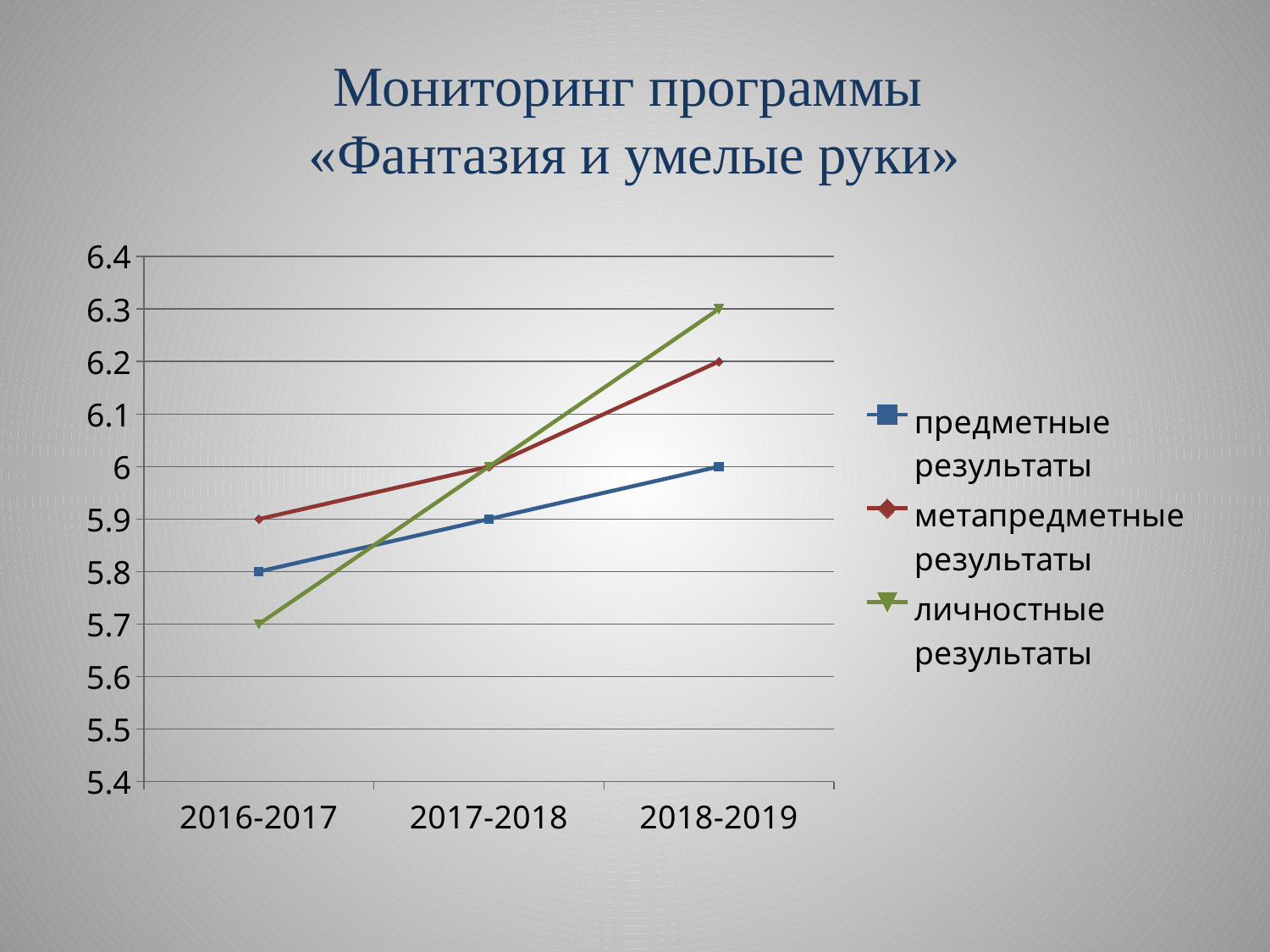
What is the value of метапредметные результаты in 2017-2018? 6 Which is larger in 2016-2017: предметные результаты or метапредметные результаты? метапредметные результаты Which series has the lowest value in 2016-2017? личностные результаты Which series has the highest value in 2018-2019? личностные результаты What is the value of предметные результаты in 2016-2017? 5.8 What colour is the line for метапредметные результаты? red Do the values of предметные результаты rise or fall from 2016-2017 to 2018-2019? rise What kind of chart is shown on the slide? line chart What is the value of личностные результаты in 2018-2019? 6.3 How many points are plotted along the x axis for each series? 3 How many series does the legend list? 3 What is the difference between личностные результаты in 2018-2019 and in 2016-2017? 0.6